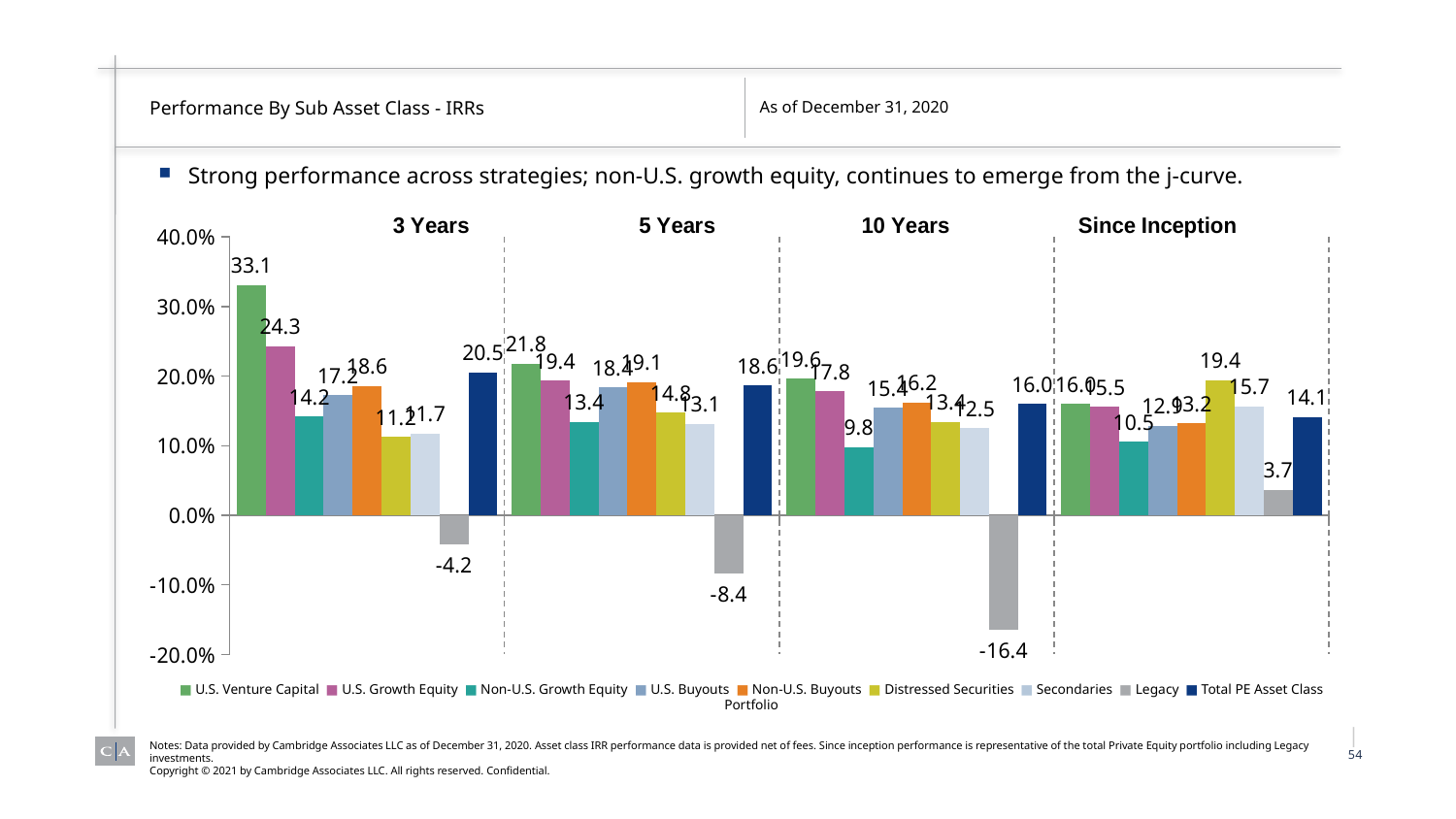
What kind of chart is shown on the slide? Bar chart How many series does the legend list? 9 In the 10 Years group, which is larger: U.S. Venture Capital or U.S. Growth Equity? U.S. Venture Capital Do the U.S. Venture Capital values rise or fall from 3 Years to Since Inception? Fall Which sub asset class has the lowest 3 Years value? Legacy Portfolio How many time-period groups are shown on the x axis? 4 What is the 3 Years value for U.S. Venture Capital? 33.1 What is the 10 Years value for the Legacy Portfolio? -16.4 What is the Since Inception value for Total PE Asset Class? 14.1 Is the Since Inception value for the Legacy Portfolio greater or less than 10.0%? less What is the difference between the 3 Years and 5 Years values for U.S. Venture Capital? 11.3 Which sub asset class has the highest Since Inception value? Distressed Securities